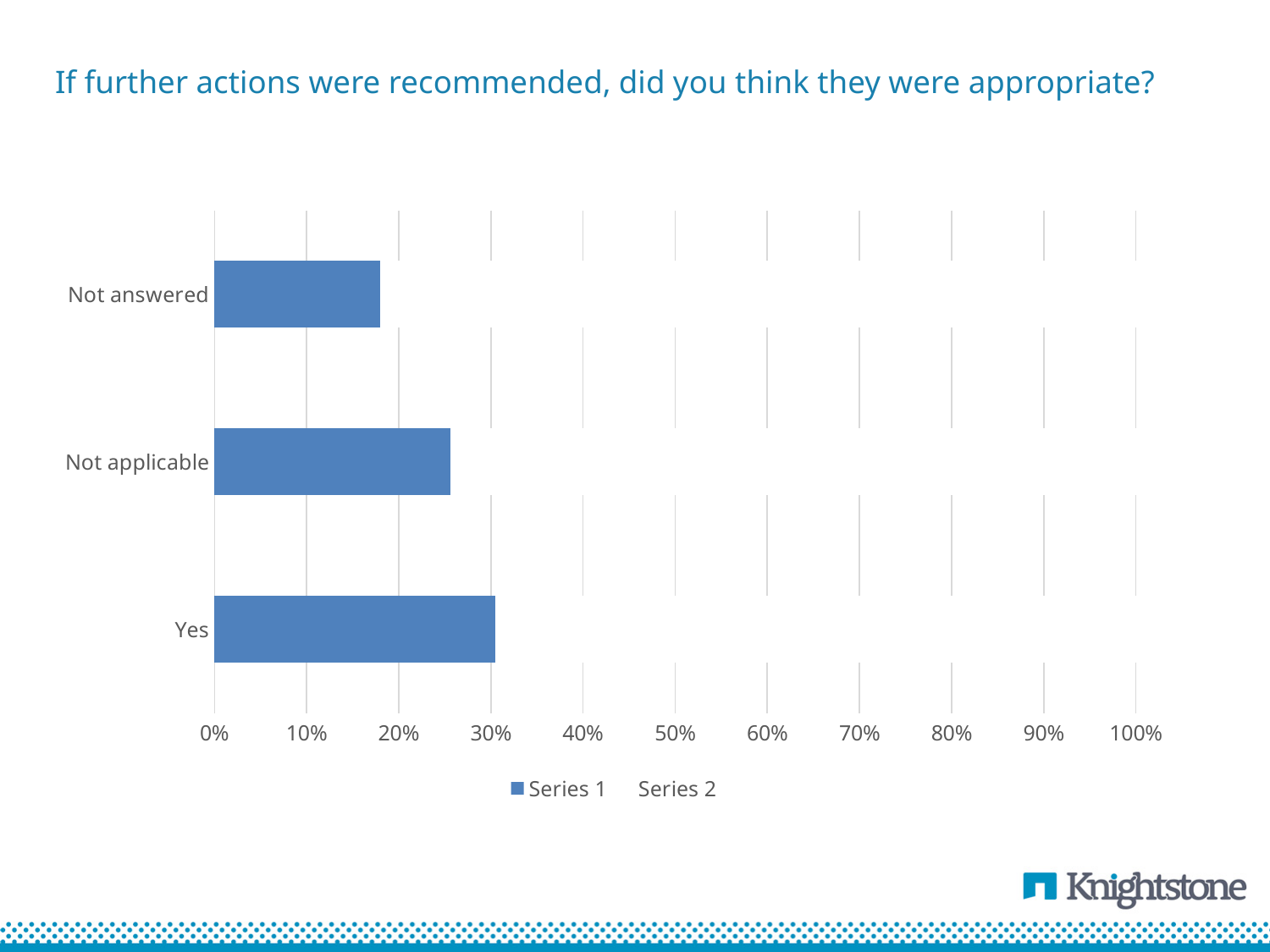
What is the title of the chart? If further actions were recommended, did you think they were appropriate? Which is larger, the value for Not applicable or the value for Not answered? Not applicable How many series does the legend list? 2 Is the value for Yes greater or less than 20%? greater How many categories are plotted in the chart? 3 What kind of chart is shown on the slide? Bar chart What are the two entries listed in the legend? Series 1 and Series 2 Which is larger, the value for Yes or the value for Not applicable? Yes Is the value for Not applicable greater or less than 20%? greater Which category has the highest value? Yes Is the value for Not answered greater or less than 20%? less Which category has the lowest value? Not answered